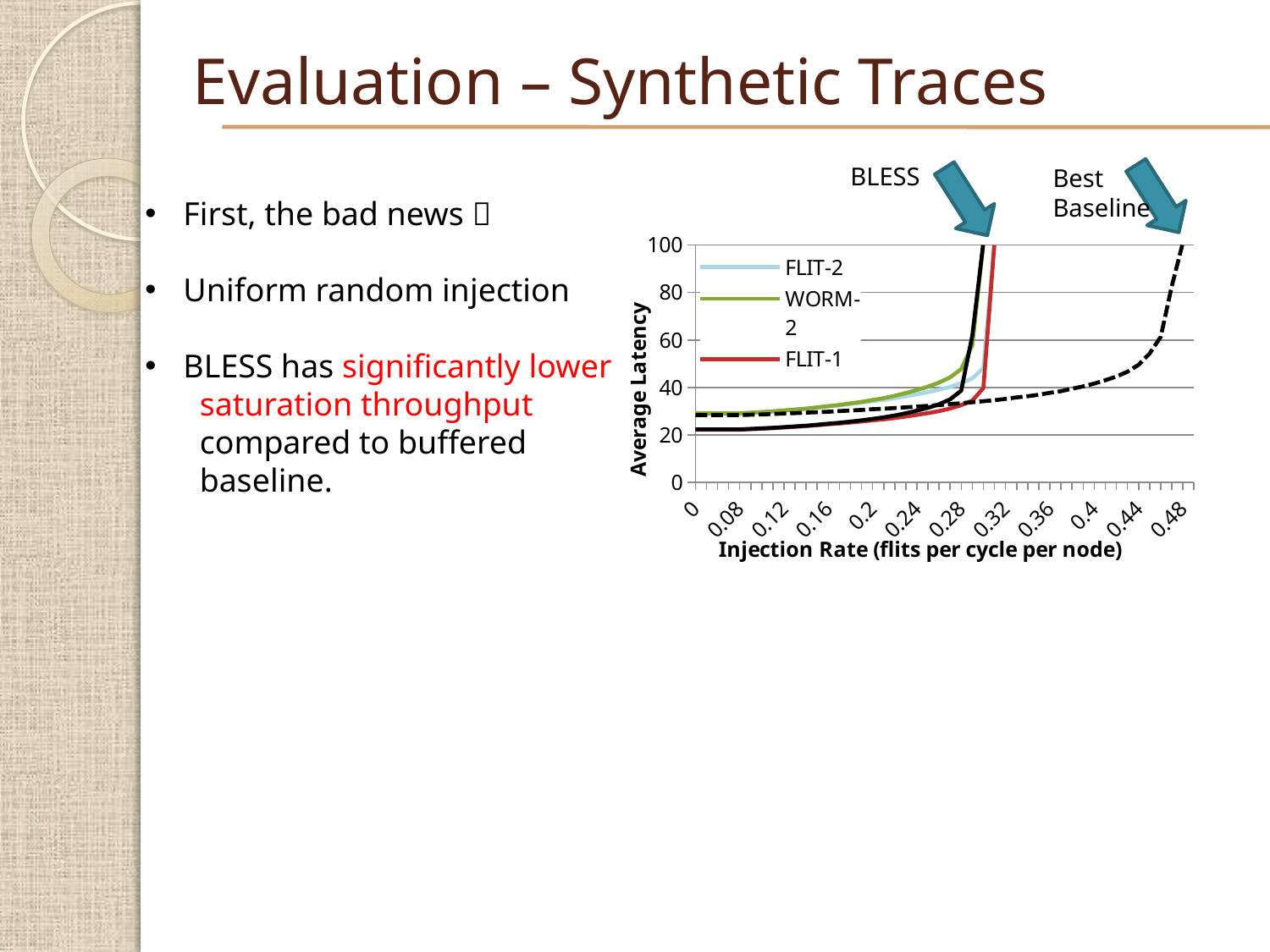
At injection rate 0.08, which is larger, the value for WORM-2 or the value for FLIT-1? WORM-2 How many series does the chart's legend list? 3 Is the value for the Best Baseline (dashed line) at injection rate 0.2 greater or less than 60? less What is the title of the chart's x axis? Injection Rate (flits per cycle per node) Is the value for WORM-2 at injection rate 0.2 greater or less than 60? less What kind of chart is shown on the slide? line chart Does the average latency rise or fall as the injection rate increases along the x axis? rise What is the title of the chart's y axis? Average Latency What is the highest value shown on the y axis of the chart? 100 Is the value for FLIT-1 at injection rate 0 greater or less than 40? less